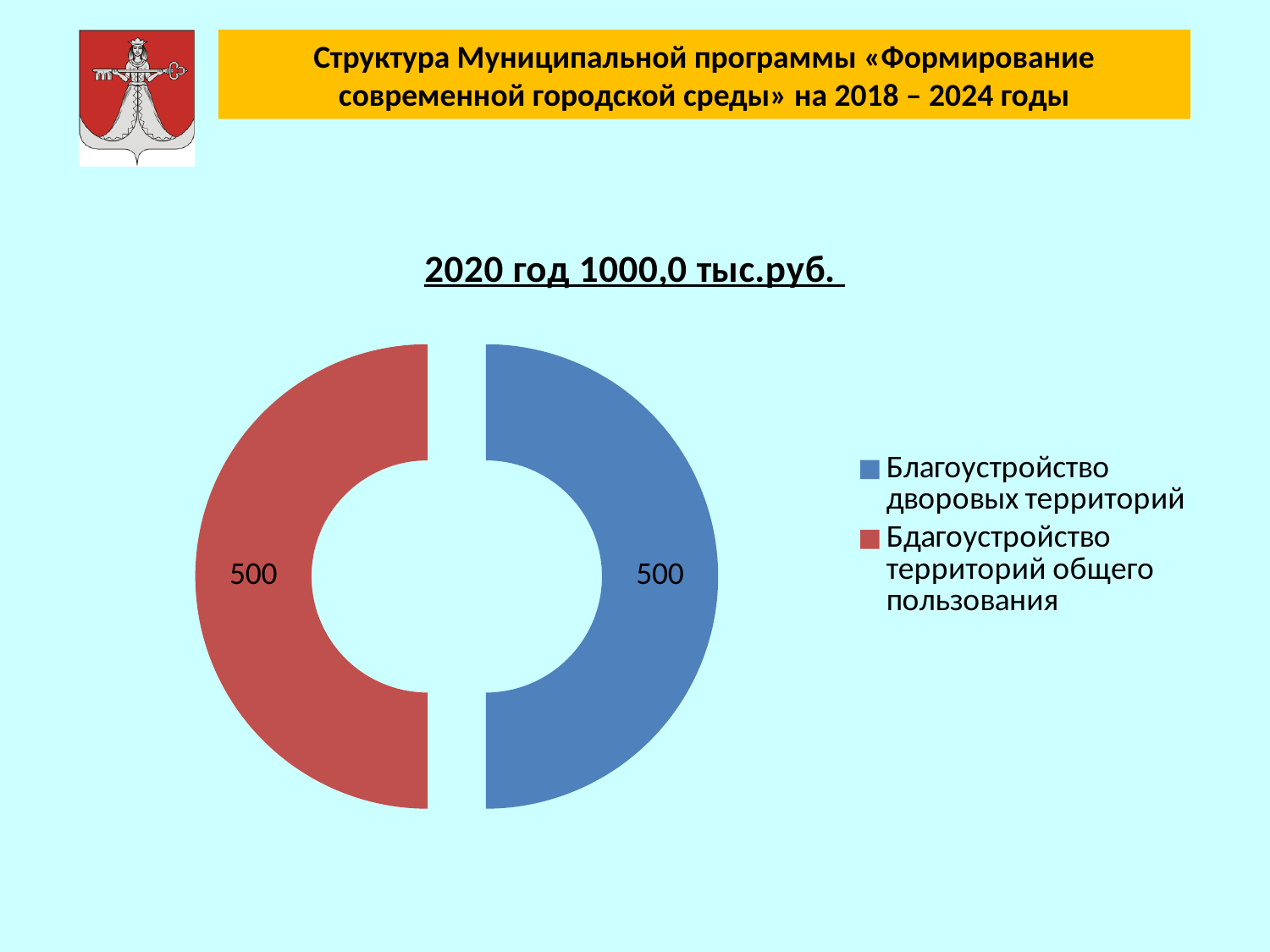
What share of the chart does Бдагоустройство территорий общего пользования represent? 50% What share of the chart does Благоустройство дворовых территорий represent? 50% How many entries does the legend list? 2 How many slices does the chart have? 2 What is the difference between the value for Благоустройство дворовых территорий and the value for Бдагоустройство территорий общего пользования? 0 Which colour represents Бдагоустройство территорий общего пользования in the chart? red What is the total of the two slices in the chart? 1000 What kind of chart is shown on the slide? doughnut chart What is the value for Благоустройство дворовых территорий? 500 What is the value for Бдагоустройство территорий общего пользования? 500 What is the title shown above the chart? 2020 год 1000,0 тыс.руб.